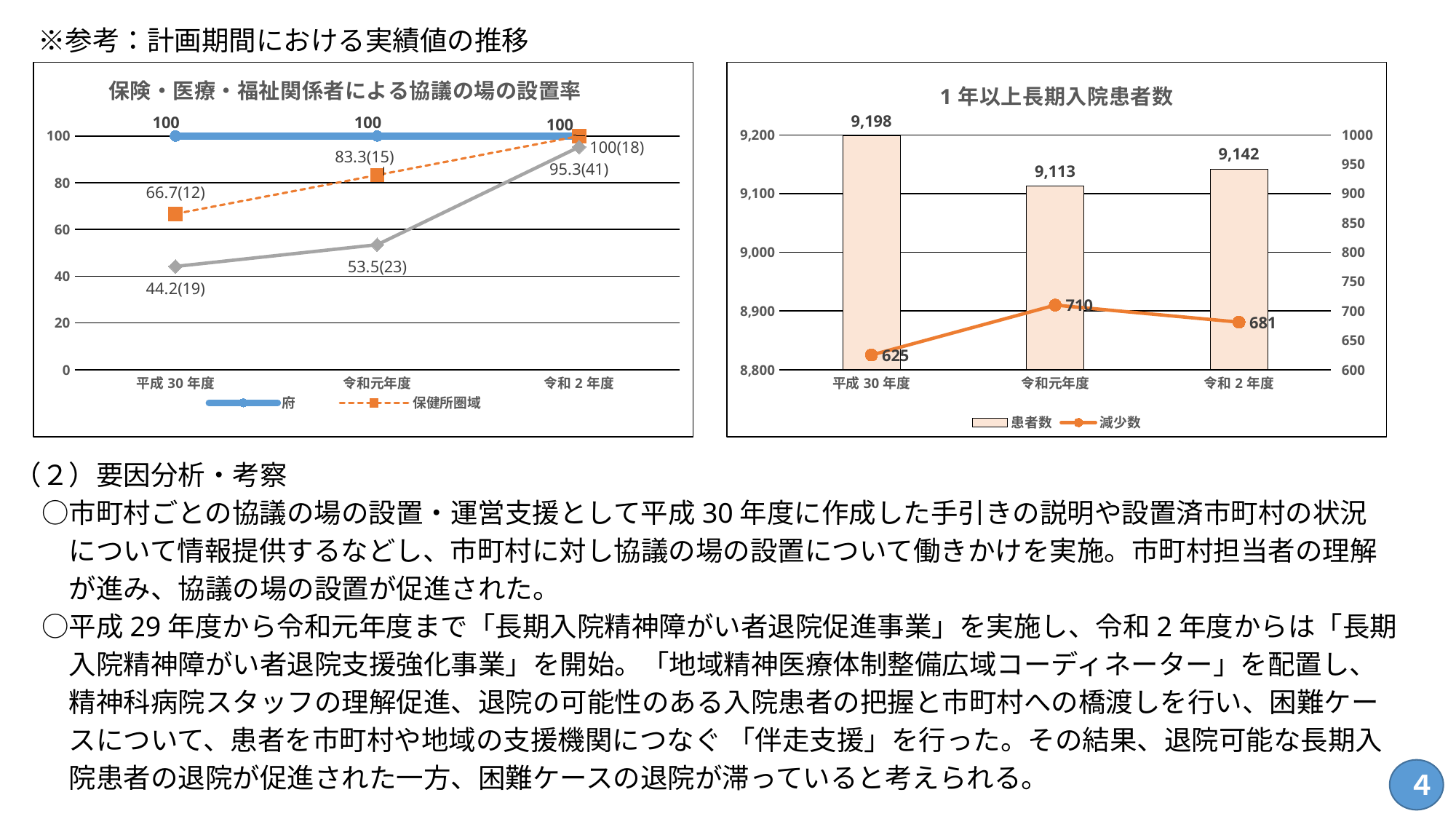
In the chart titled 保険・医療・福祉関係者による協議の場の設置率, what is the value for 保健所圏域 in 令和元年度? 83.3(15) In the chart titled 1年以上長期入院患者数, what is the 減少数 value for 令和元年度? 710 In the chart titled 1年以上長期入院患者数, is the 減少数 for 令和2年度 greater or less than 681 for 平成30年度's 625? greater In the chart titled 保険・医療・福祉関係者による協議の場の設置率, does the 保健所圏域 series rise or fall from 平成30年度 to 令和2年度? rise In the chart titled 保険・医療・福祉関係者による協議の場の設置率, how many years are shown on the x axis? 3 In the chart titled 保険・医療・福祉関係者による協議の場の設置率, what is the value for 府 in 平成30年度? 100 In the chart titled 1年以上長期入院患者数, which year has the highest 減少数? 令和元年度 In the chart titled 1年以上長期入院患者数, what is the 患者数 value for 平成30年度? 9,198 In the chart titled 1年以上長期入院患者数, what is the difference in 患者数 between 平成30年度 and 令和2年度? 56 In the chart titled 1年以上長期入院患者数, how many series does the legend list? 2 In the chart titled 1年以上長期入院患者数, which year has the lowest 患者数? 令和元年度 What kind of chart is the one titled 保険・医療・福祉関係者による協議の場の設置率? line chart